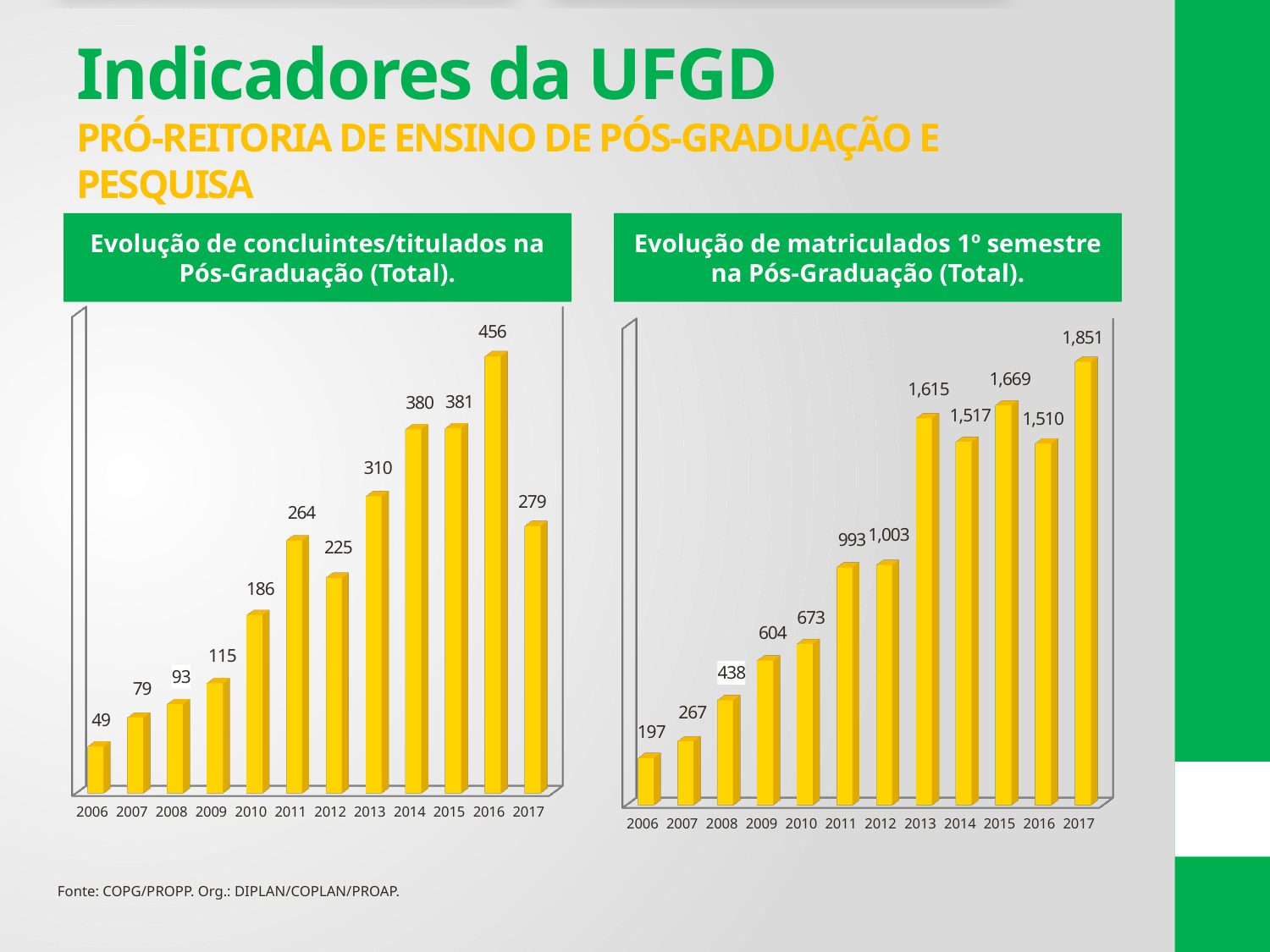
In the chart 'Evolução de concluintes/titulados na Pós-Graduação (Total)', which year has the lowest value? 2006 In the chart 'Evolução de concluintes/titulados na Pós-Graduação (Total)', what is the difference between the values for 2016 and 2017? 177 In the chart 'Evolução de concluintes/titulados na Pós-Graduação (Total)', which is larger, the value for 2011 or the value for 2012? 2011 In the chart 'Evolução de matriculados 1º semestre na Pós-Graduação (Total)', what is the value for 2013? 1,615 In the chart 'Evolução de concluintes/titulados na Pós-Graduação (Total)', what is the value for 2016? 456 In the chart 'Evolução de matriculados 1º semestre na Pós-Graduação (Total)', do the values generally rise or fall from 2006 to 2012? Rise In the chart 'Evolução de matriculados 1º semestre na Pós-Graduação (Total)', what is the difference between the values for 2017 and 2016? 341 In the chart 'Evolução de matriculados 1º semestre na Pós-Graduação (Total)', which year has the highest value? 2017 How many years are shown in the chart 'Evolução de concluintes/titulados na Pós-Graduação (Total)'? 12 In the chart 'Evolução de matriculados 1º semestre na Pós-Graduação (Total)', what is the value for 2006? 197 What kind of chart is 'Evolução de concluintes/titulados na Pós-Graduação (Total)'? Bar chart In the chart 'Evolução de matriculados 1º semestre na Pós-Graduação (Total)', which is larger, the value for 2014 or the value for 2015? 2015